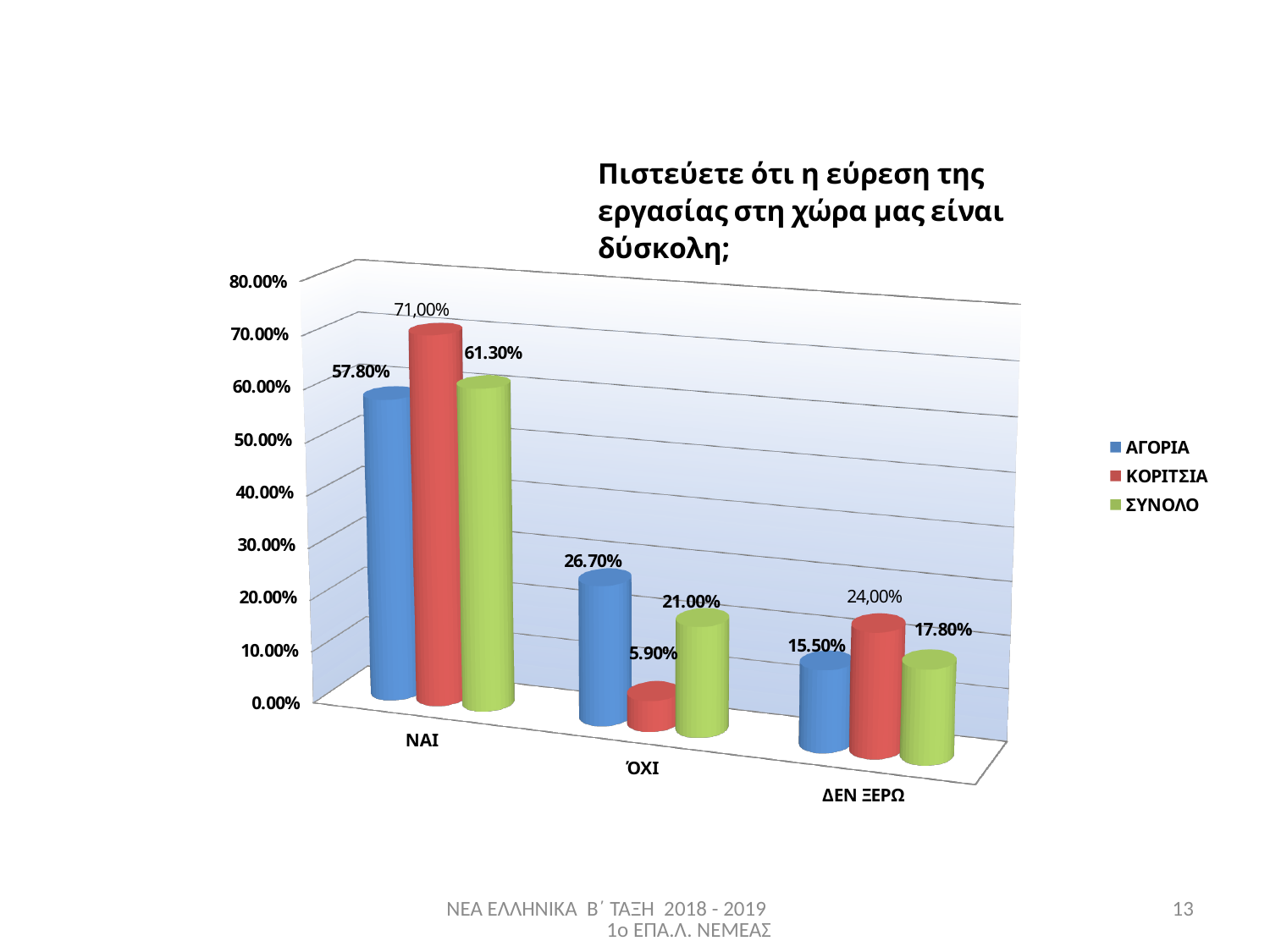
How many series does the legend list? 3 What is the value for ΑΓΟΡΙΑ in the ΝΑΙ category? 57.80% What is the value for ΚΟΡΙΤΣΙΑ in the ΔΕΝ ΞΕΡΩ category? 24,00% Which category has the highest value for the ΣΥΝΟΛΟ series? ΝΑΙ Which colour represents the ΣΥΝΟΛΟ series? Green What is the value for ΚΟΡΙΤΣΙΑ in the ΝΑΙ category? 71,00% In the ΔΕΝ ΞΕΡΩ category, which is larger: ΑΓΟΡΙΑ or ΚΟΡΙΤΣΙΑ? ΚΟΡΙΤΣΙΑ How many categories are shown on the x axis? 3 What kind of chart is shown on the slide? Bar chart What is the value for ΣΥΝΟΛΟ in the ΌΧΙ category? 21.00% What is the difference between the ΚΟΡΙΤΣΙΑ and ΑΓΟΡΙΑ values in the ΌΧΙ category? 20.80% Which category has the lowest value for the ΚΟΡΙΤΣΙΑ series? ΌΧΙ